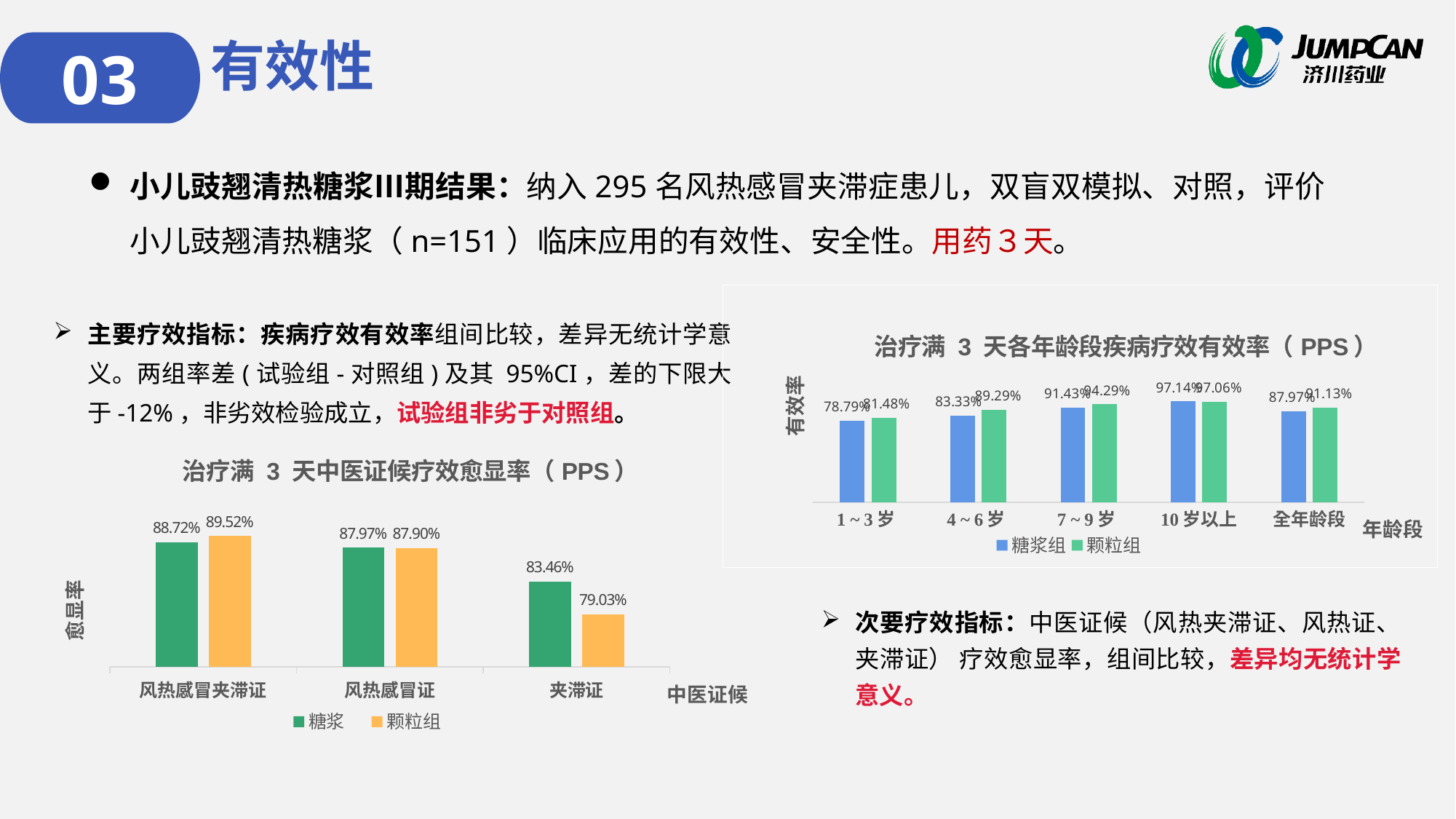
In the chart titled 治疗满 3 天各年龄段疾病疗效有效率（PPS）, what is the value for 糖浆组 in the 10 岁以上 category? 97.14% In the chart titled 治疗满 3 天各年龄段疾病疗效有效率（PPS）, which is larger in the 4～6 岁 category, 糖浆组 or 颗粒组? 颗粒组 In the chart titled 治疗满 3 天中医证候疗效愈显率（PPS）, which category has the lowest value for 颗粒组? 夹滞证 In the chart titled 治疗满 3 天各年龄段疾病疗效有效率（PPS）, what is the difference between 颗粒组 and 糖浆组 in the 全年龄段 category? 3.16% In the chart titled 治疗满 3 天各年龄段疾病疗效有效率（PPS）, how many series does the legend list? 2 In the chart titled 治疗满 3 天中医证候疗效愈显率（PPS）, what is the value for 颗粒组 in the 风热感冒夹滞证 category? 89.52% In the chart titled 治疗满 3 天中医证候疗效愈显率（PPS）, what is the difference between 糖浆 and 颗粒组 in the 夹滞证 category? 4.43% In the chart titled 治疗满 3 天各年龄段疾病疗效有效率（PPS）, which age group has the lowest value for 糖浆组? 1～3 岁 In the chart titled 治疗满 3 天各年龄段疾病疗效有效率（PPS）, what is the value for 颗粒组 in the 4～6 岁 category? 89.29% In the chart titled 治疗满 3 天中医证候疗效愈显率（PPS）, what kind of chart is it? Bar chart In the chart titled 治疗满 3 天中医证候疗效愈显率（PPS）, what is the value for 糖浆 in the 夹滞证 category? 83.46% In the chart titled 治疗满 3 天中医证候疗效愈显率（PPS）, how many categories are shown on the x axis? 3